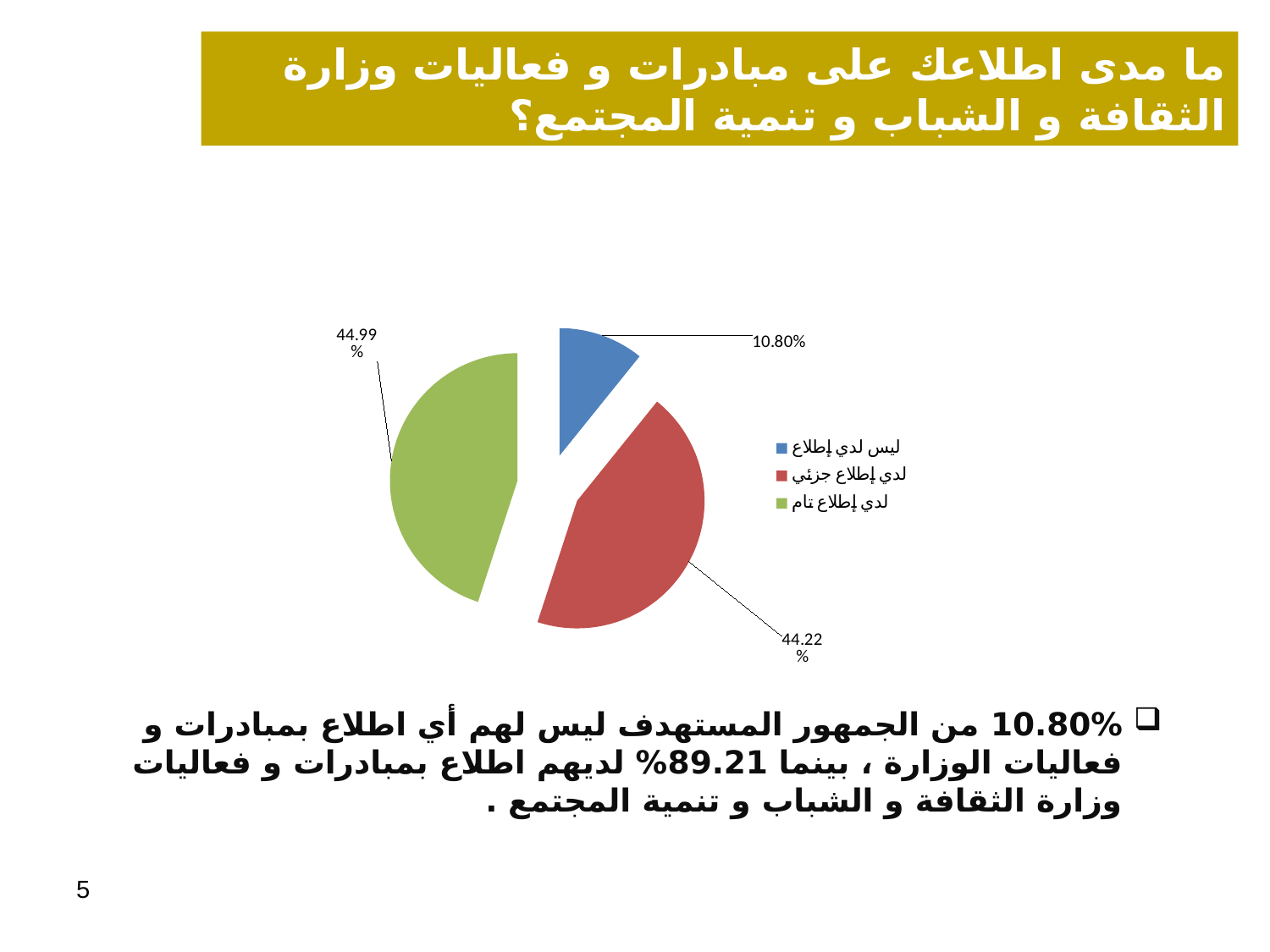
How many entries does the legend of the pie chart list? 3 What kind of chart is shown on the slide? Pie chart What percentage is shown for the slice "ليس لدي إطلاع"? 10.80% What is the combined share of "لدي إطلاع جزئي" and "لدي إطلاع تام"? 89.21% Which is larger: the slice for "لدي إطلاع جزئي" or the slice for "ليس لدي إطلاع"? لدي إطلاع جزئي Which category has the smallest slice of the pie? ليس لدي إطلاع What colour is the slice for "لدي إطلاع تام"? Green What percentage is shown for the slice "لدي إطلاع تام"? 44.99% What is the difference in percentage points between "لدي إطلاع جزئي" and "ليس لدي إطلاع"? 33.42 How many slices does the pie chart have? 3 What percentage is shown for the slice "لدي إطلاع جزئي"? 44.22% Which category has the largest slice of the pie? لدي إطلاع تام